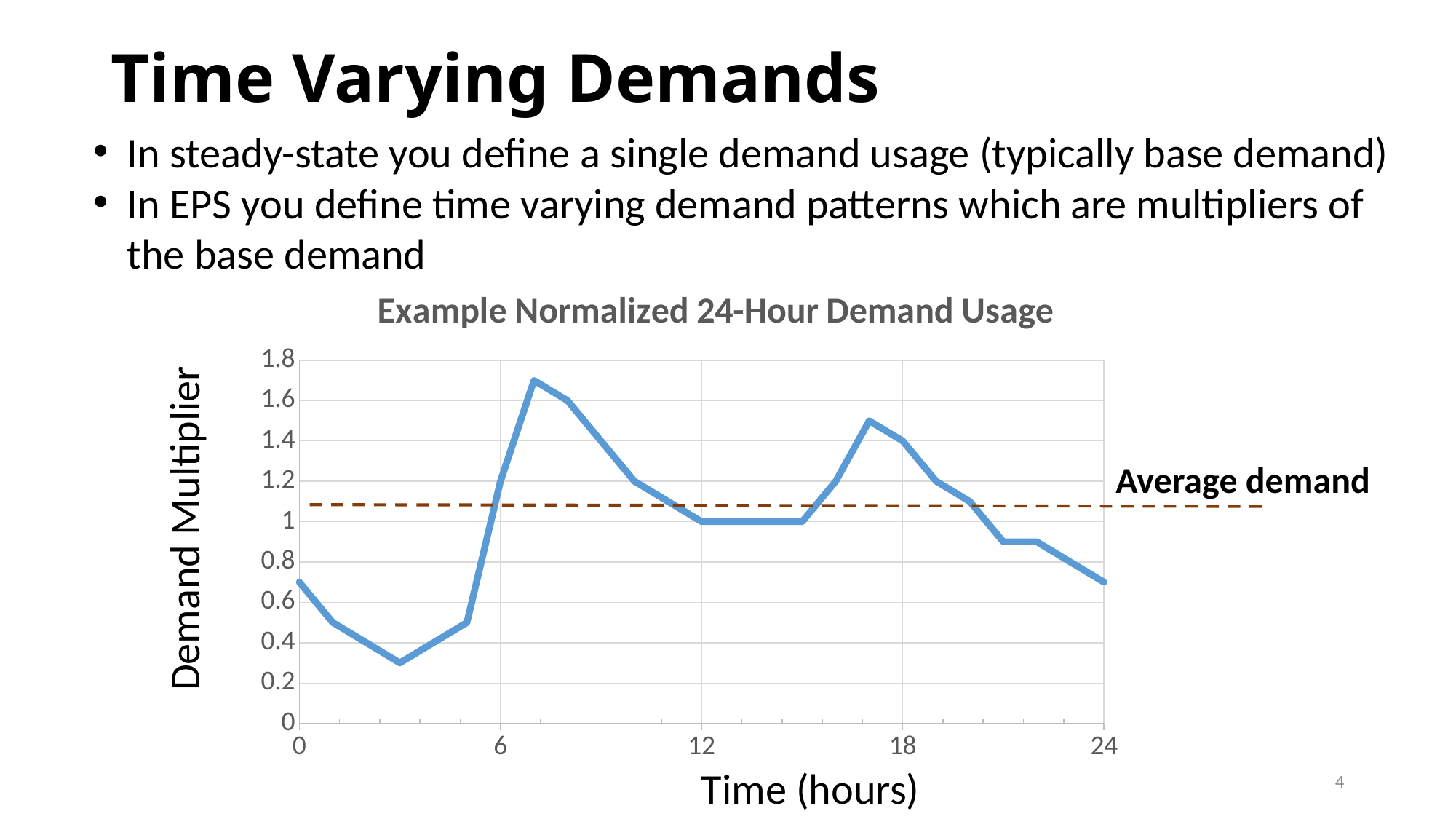
What is the title of the chart? Example Normalized 24-Hour Demand Usage What is the demand multiplier at hour 12? 1 Is the demand multiplier at hour 0 greater or less than 0.8? less Is the demand multiplier at hour 6 greater or less than 1? greater Does the demand multiplier rise or fall between hour 18 and hour 24? fall Is the highest demand multiplier on the chart greater or less than 1.6? greater What kind of chart is shown on the slide? line chart What is the demand multiplier at hour 18? 1.4 What is the difference between the demand multiplier at hour 18 and at hour 12? 0.4 Which is larger, the demand multiplier at hour 12 or at hour 18? hour 18 What does the dashed horizontal line on the chart represent? Average demand